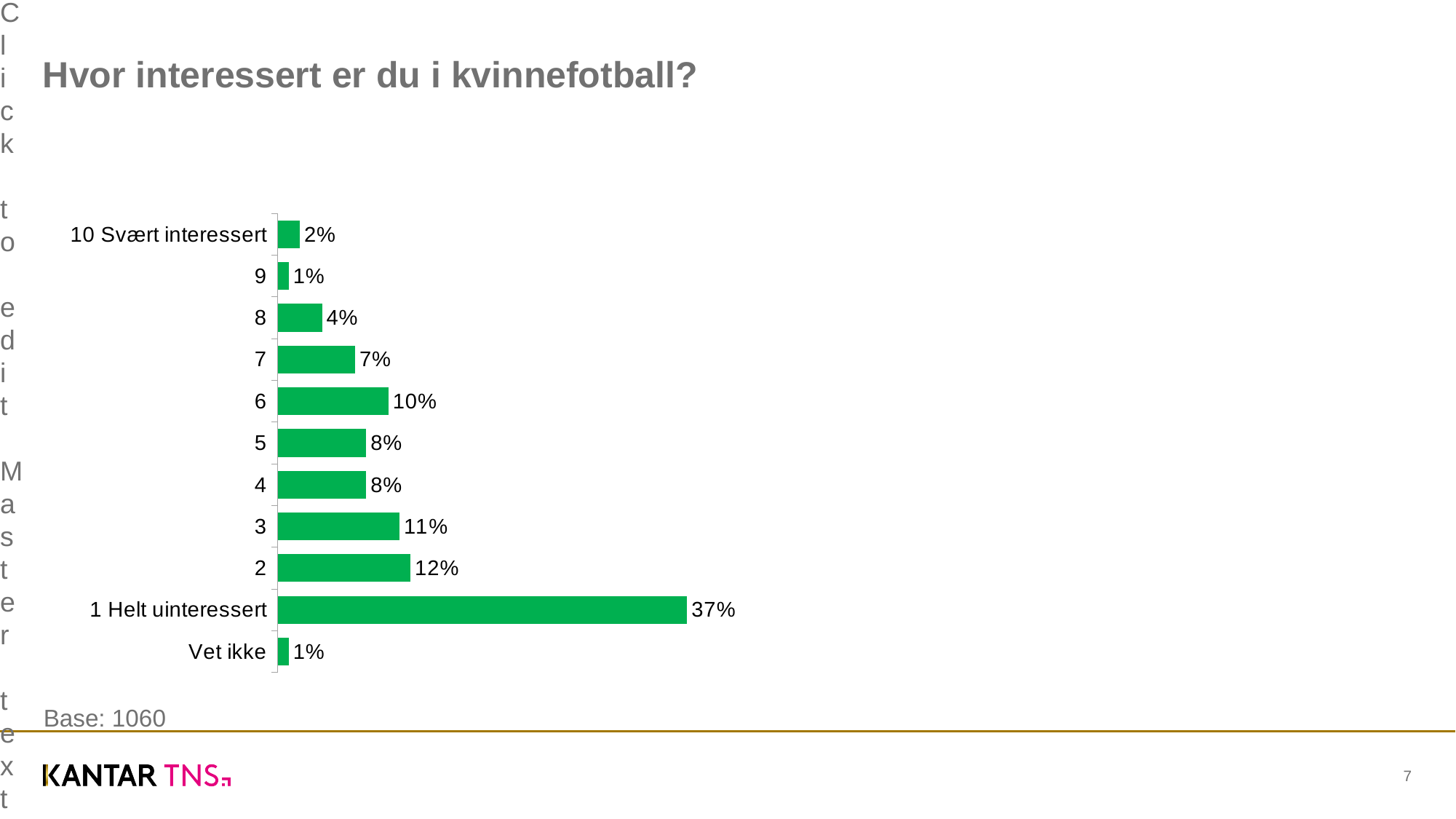
What percentage answered "10 Svært interessert"? 2% What percentage of respondents answered "1 Helt uinteressert"? 37% What is the value for "Vet ikke"? 1% What is the title of the chart? Hvor interessert er du i kvinnefotball? What is the base (number of respondents) stated on the slide? 1060 What is the difference between the values for category 2 and category 3? 1% What is the value shown for category 6? 10% What is the difference between the values for "1 Helt uinteressert" and category 2? 25% Which is larger, the value for category 7 or the value for category 8? 7 Which category has the highest value? 1 Helt uinteressert How many categories are shown in the chart? 11 What kind of chart is shown on the slide? Bar chart